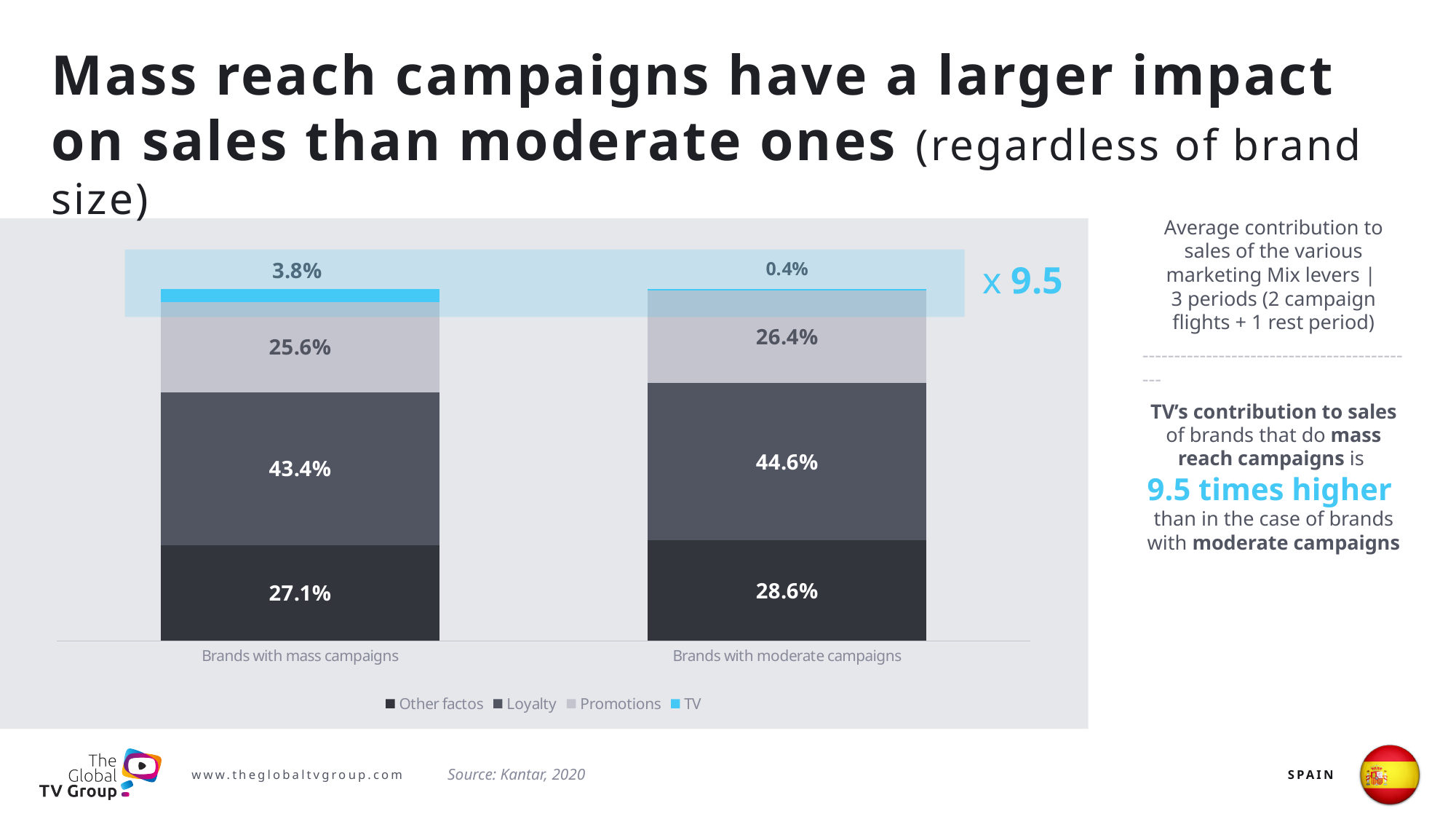
Which series has the largest value in the Brands with mass campaigns bar? Loyalty What is the difference between the TV values for Brands with mass campaigns and Brands with moderate campaigns? 3.4% What is the Other factos value for Brands with moderate campaigns? 28.6% What is the TV contribution for Brands with mass campaigns? 3.8% How many categories are shown on the x axis? 2 What kind of chart is shown on the slide? Stacked bar chart What is the Loyalty value for Brands with moderate campaigns? 44.6% Which series has the smallest value in the Brands with moderate campaigns bar? TV Which category has the larger Loyalty value, Brands with mass campaigns or Brands with moderate campaigns? Brands with moderate campaigns What is the TV contribution for Brands with moderate campaigns? 0.4% What is the Promotions value for Brands with mass campaigns? 25.6% How many series does the legend list? 4